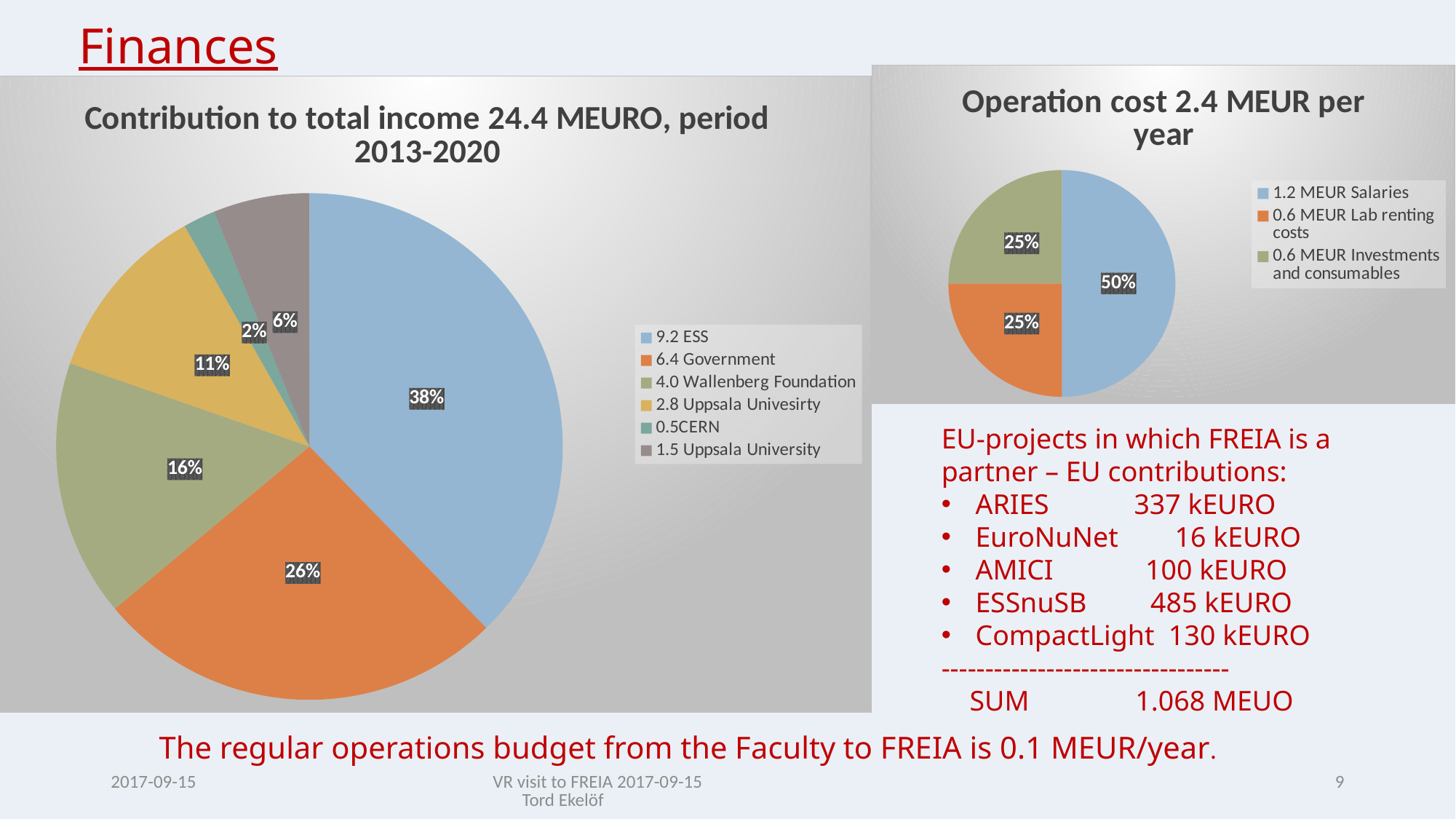
In the 'Contribution to total income 24.4 MEURO, period 2013-2020' chart, which contributor has the smallest slice? CERN In the 'Contribution to total income 24.4 MEURO, period 2013-2020' chart, which contributor has the largest slice? ESS What type of chart is the 'Operation cost 2.4 MEUR per year' chart? Pie chart In the 'Contribution to total income 24.4 MEURO, period 2013-2020' chart, what is the difference in percentage points between the ESS slice and the Government slice? 12 percentage points In the 'Contribution to total income 24.4 MEURO, period 2013-2020' chart, what percentage is shown for the Wallenberg Foundation? 16% In the 'Contribution to total income 24.4 MEURO, period 2013-2020' chart, which is larger, the Wallenberg Foundation slice or the Government slice? Government In the 'Operation cost 2.4 MEUR per year' chart, what colour is the Salaries slice? Blue In the 'Operation cost 2.4 MEUR per year' chart, what share of the pie is Salaries? 50% In the 'Contribution to total income 24.4 MEURO, period 2013-2020' chart, what share of the pie does ESS have? 38% In the 'Contribution to total income 24.4 MEURO, period 2013-2020' chart, how many slices does the pie have? 6 In the 'Operation cost 2.4 MEUR per year' chart, how many entries does the legend list? 3 In the 'Contribution to total income 24.4 MEURO, period 2013-2020' chart, what percentage is shown for Government? 26%